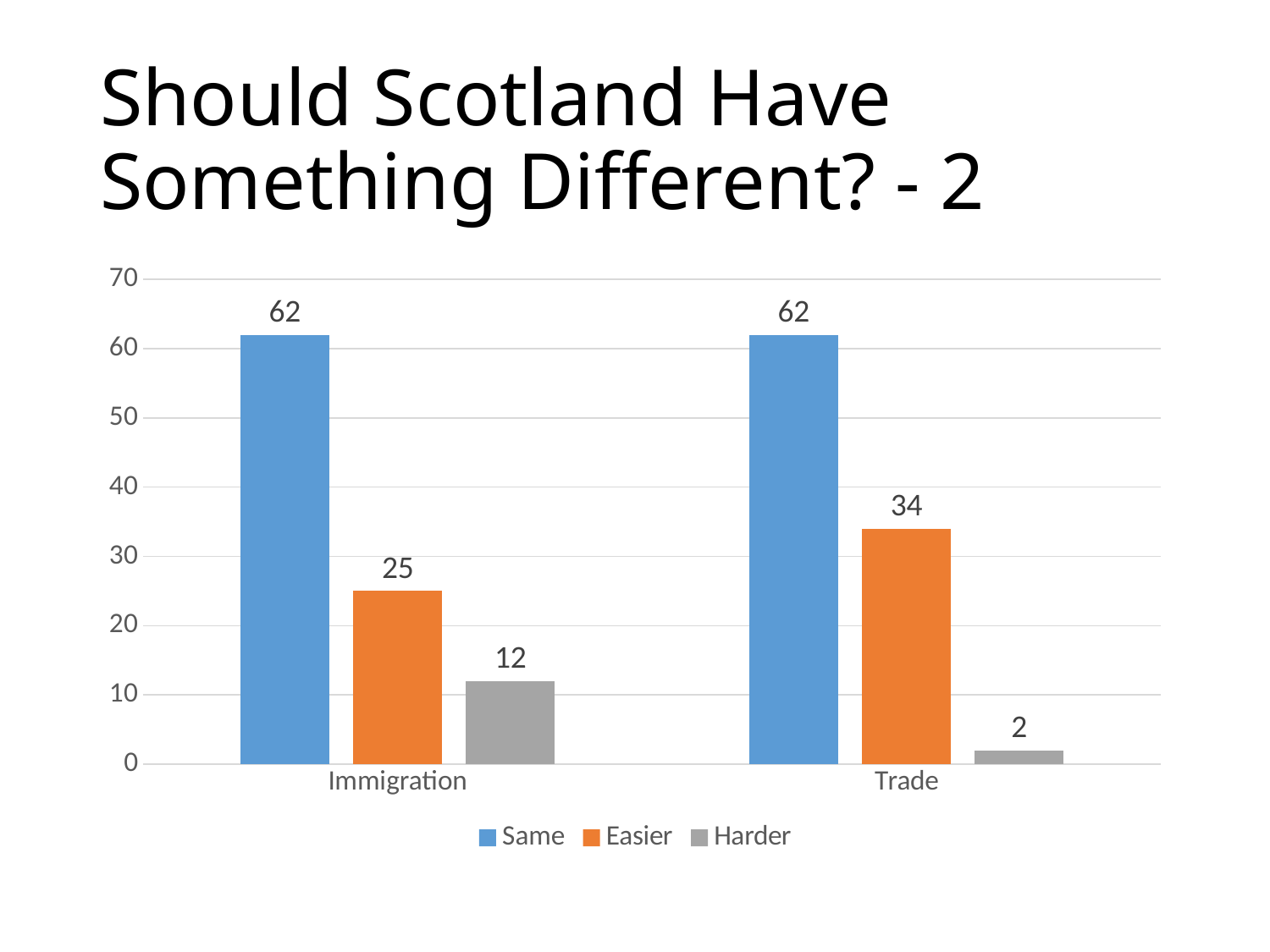
What is the value for Same in the Immigration category? 62 What is the value for Easier in the Trade category? 34 What is the value for Harder in the Immigration category? 12 Which is larger: the Harder value for Immigration or the Harder value for Trade? Immigration Which series has the lowest value in the Trade category? Harder What is the difference between the Easier values for Trade and Immigration? 9 What kind of chart is shown on the slide? Bar chart Which colour represents the Easier series in the legend? Orange Which series has the highest value in the Immigration category? Same What is the value for Harder in the Trade category? 2 How many categories are shown on the x axis? 2 How many series does the legend list? 3